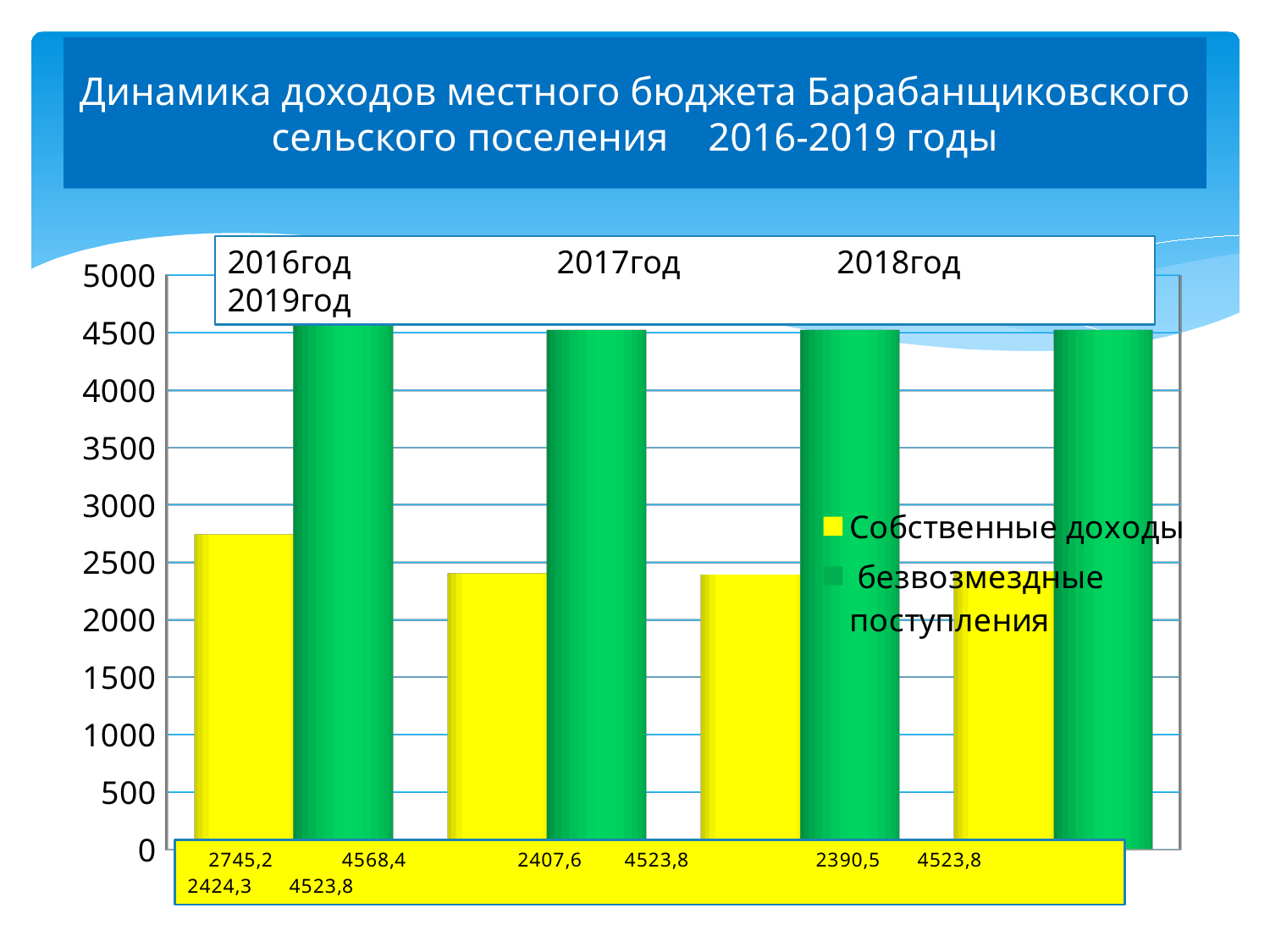
Which is larger in 2019год: Собственные доходы or безвозмездные поступления? безвозмездные поступления How many years are shown on the chart? 4 What is the difference between Собственные доходы in 2016год and 2017год? 337,6 What is the value of Собственные доходы for 2018год? 2390,5 What is the value of Собственные доходы for 2016год? 2745,2 In which year is Собственные доходы the lowest? 2018год What type of chart is shown on the slide? bar chart What is the value of безвозмездные поступления for 2017год? 4523,8 In which year is Собственные доходы the highest? 2016год Is the value of Собственные доходы for 2017год greater or less than 2500? less How many series does the legend list? 2 What is the value of безвозмездные поступления for 2016год? 4568,4